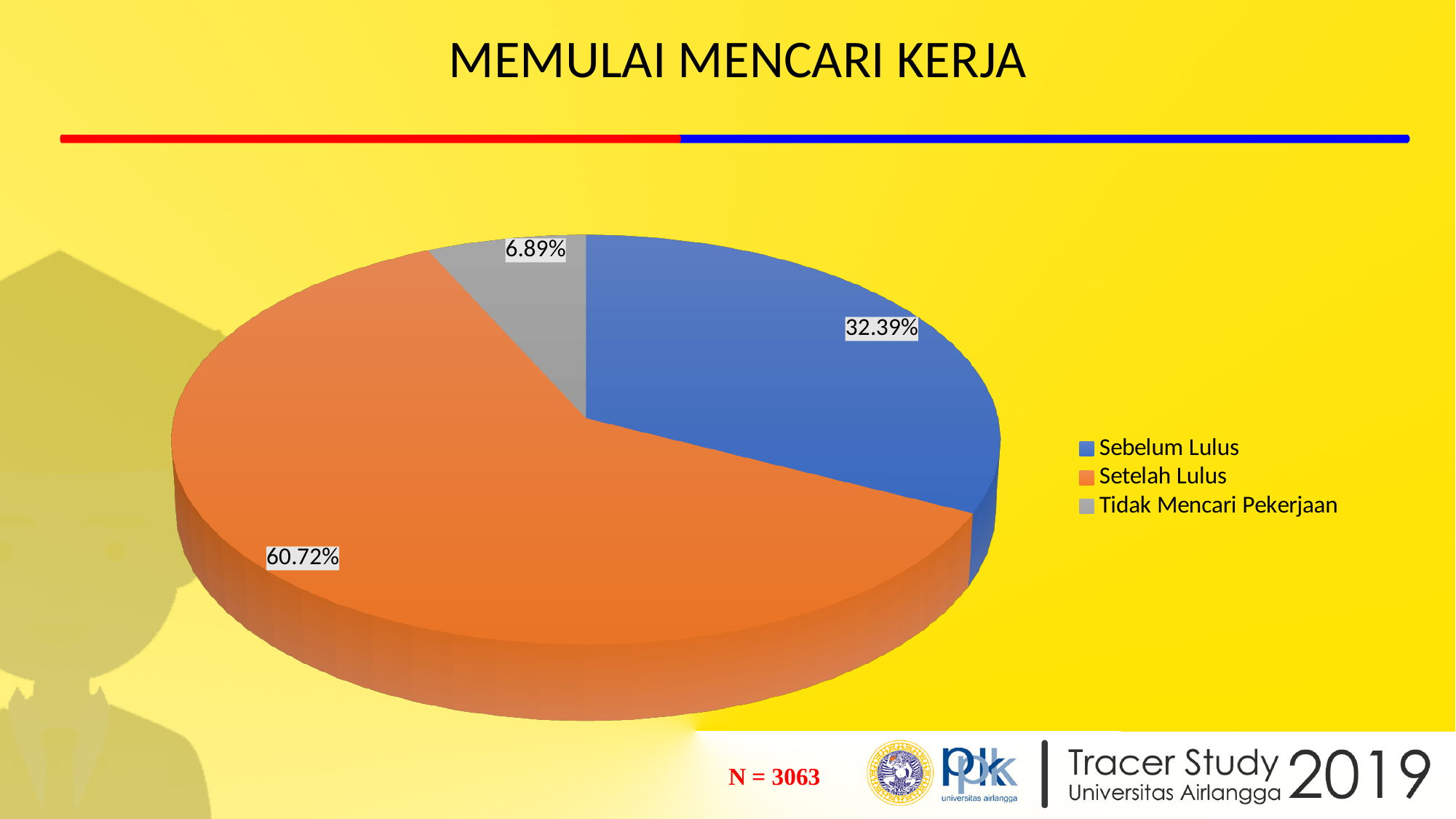
What kind of chart is shown on the slide? Pie chart Which is larger, the share for 'Sebelum Lulus' or for 'Tidak Mencari Pekerjaan'? Sebelum Lulus What percentage is shown for 'Setelah Lulus'? 60.72% What percentage is shown for 'Tidak Mencari Pekerjaan'? 6.89% Which category has the smallest share of the pie? Tidak Mencari Pekerjaan Which colour represents 'Setelah Lulus' in the pie chart? Orange What is the difference in percentage points between 'Setelah Lulus' and 'Sebelum Lulus'? 28.33 Which category has the largest share of the pie? Setelah Lulus How many categories does the pie chart show? 3 What is the sample size (N) shown on the slide? 3063 What is the title of the slide? MEMULAI MENCARI KERJA What percentage of respondents started looking for work 'Sebelum Lulus'? 32.39%